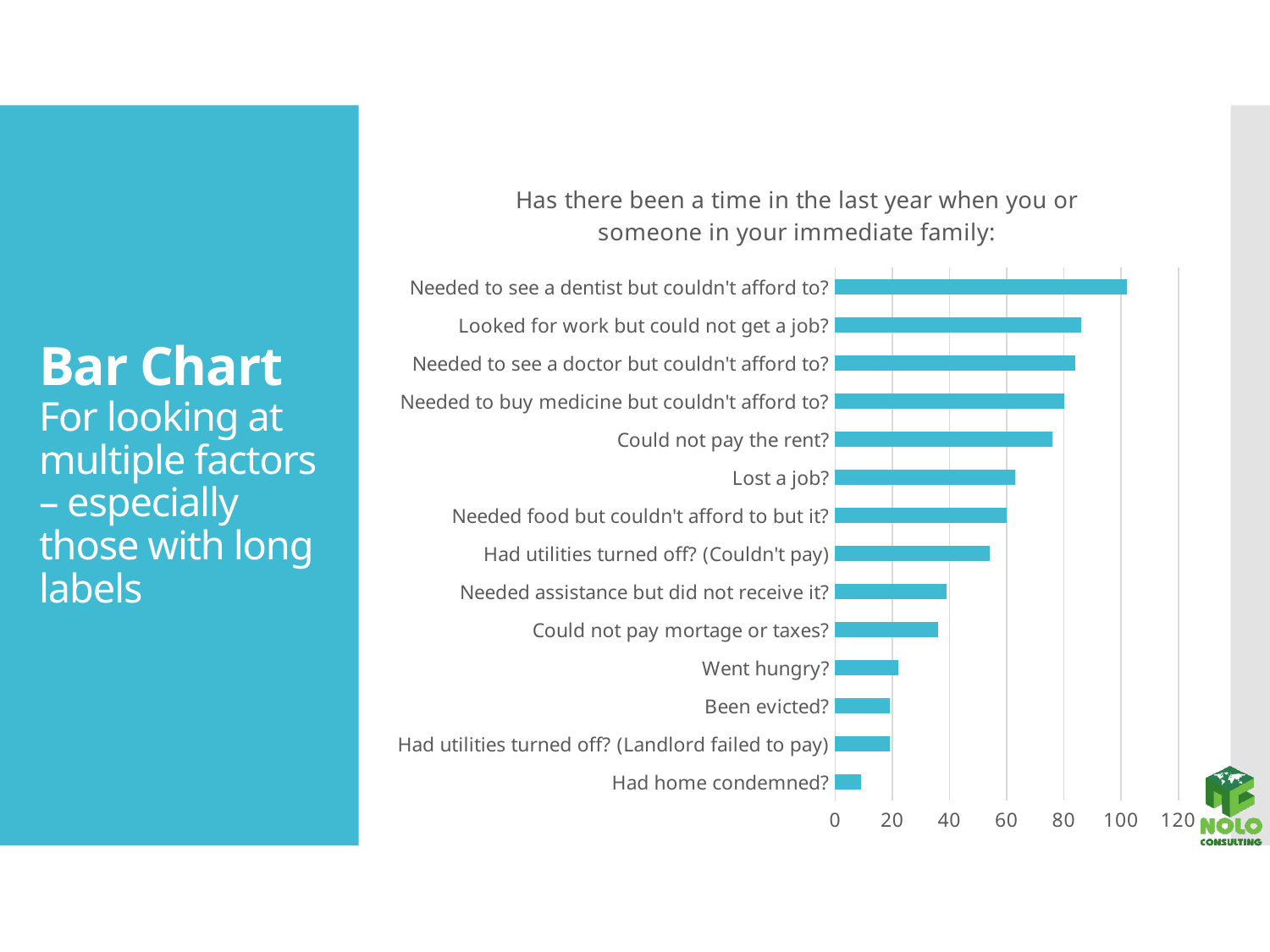
Is the value for "Looked for work but could not get a job?" greater or less than 80? greater Is the value for "Could not pay mortage or taxes?" greater or less than 40? less Which is larger: the value for "Could not pay the rent?" or the value for "Lost a job?" Could not pay the rent? Is the value for "Needed to see a dentist but couldn't afford to?" greater or less than 80? greater How many categories are plotted in the chart? 14 What is the title of the chart? Has there been a time in the last year when you or someone in your immediate family: What kind of chart is shown on the slide? bar chart Which is larger: the value for "Went hungry?" or the value for "Needed food but couldn't afford to but it?" Needed food but couldn't afford to but it? Which category has the lowest value? Had home condemned? Which category has the highest value? Needed to see a dentist but couldn't afford to?